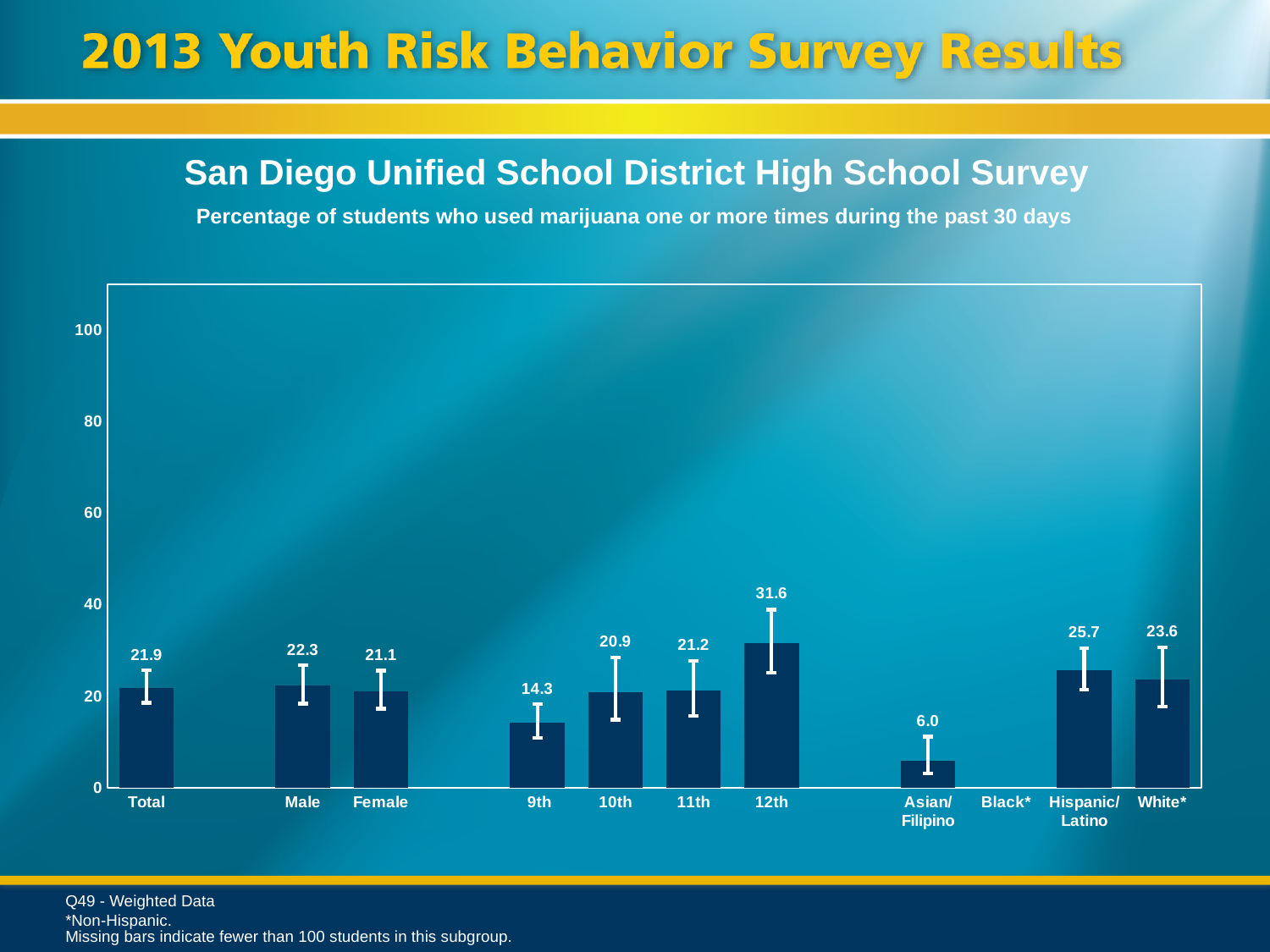
What is the value for Total? 21.9 Do the values rise or fall from 9th grade to 12th grade? rise What is the value for Asian/Filipino students? 6.0 Which is larger, the value for Male or the value for Female? Male What kind of chart is shown on the slide? bar chart What is the value for Hispanic/Latino students? 25.7 Is the value for White* greater or less than 20? greater Which category with a plotted bar has the lowest value? Asian/Filipino Which category has no bar plotted? Black* What is the value for 12th grade? 31.6 Which category has the highest value? 12th What is the difference between the values for 12th and 9th grade? 17.3